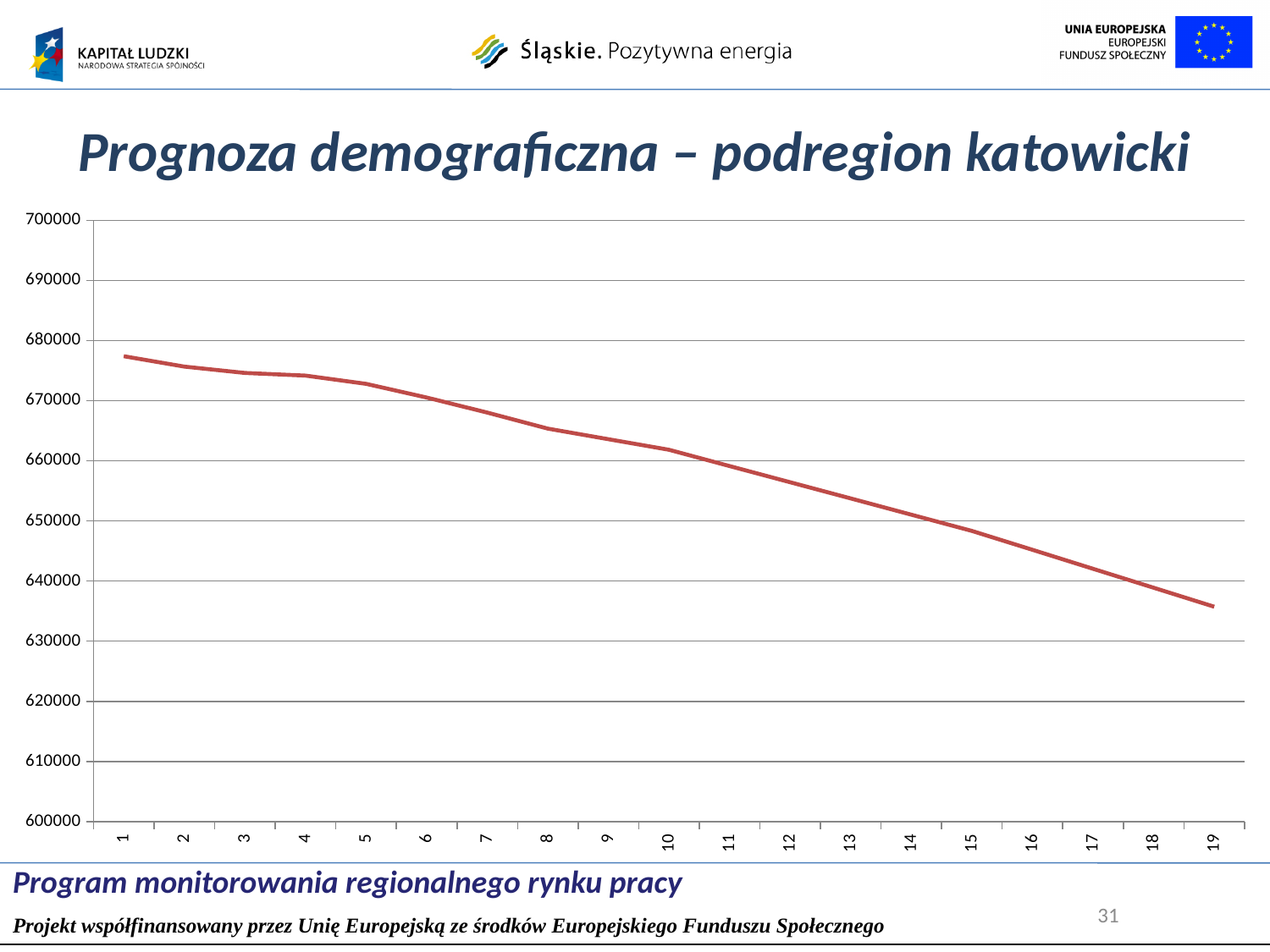
Is the value at point 1 greater or less than 670000? greater Is the value at point 8 greater or less than 670000? less How many points are plotted along the x axis of the chart? 19 Which has the larger value, point 5 or point 15? point 5 At which x-axis point is the plotted value lowest? 19 What kind of chart is shown on the slide? line chart What is the title of the chart on the slide? Prognoza demograficzna – podregion katowicki Do the values rise or fall as the x axis goes from 1 to 19? fall Is the value at point 19 greater or less than 640000? less What colour is the plotted line on the chart? red At which x-axis point is the plotted value highest? 1